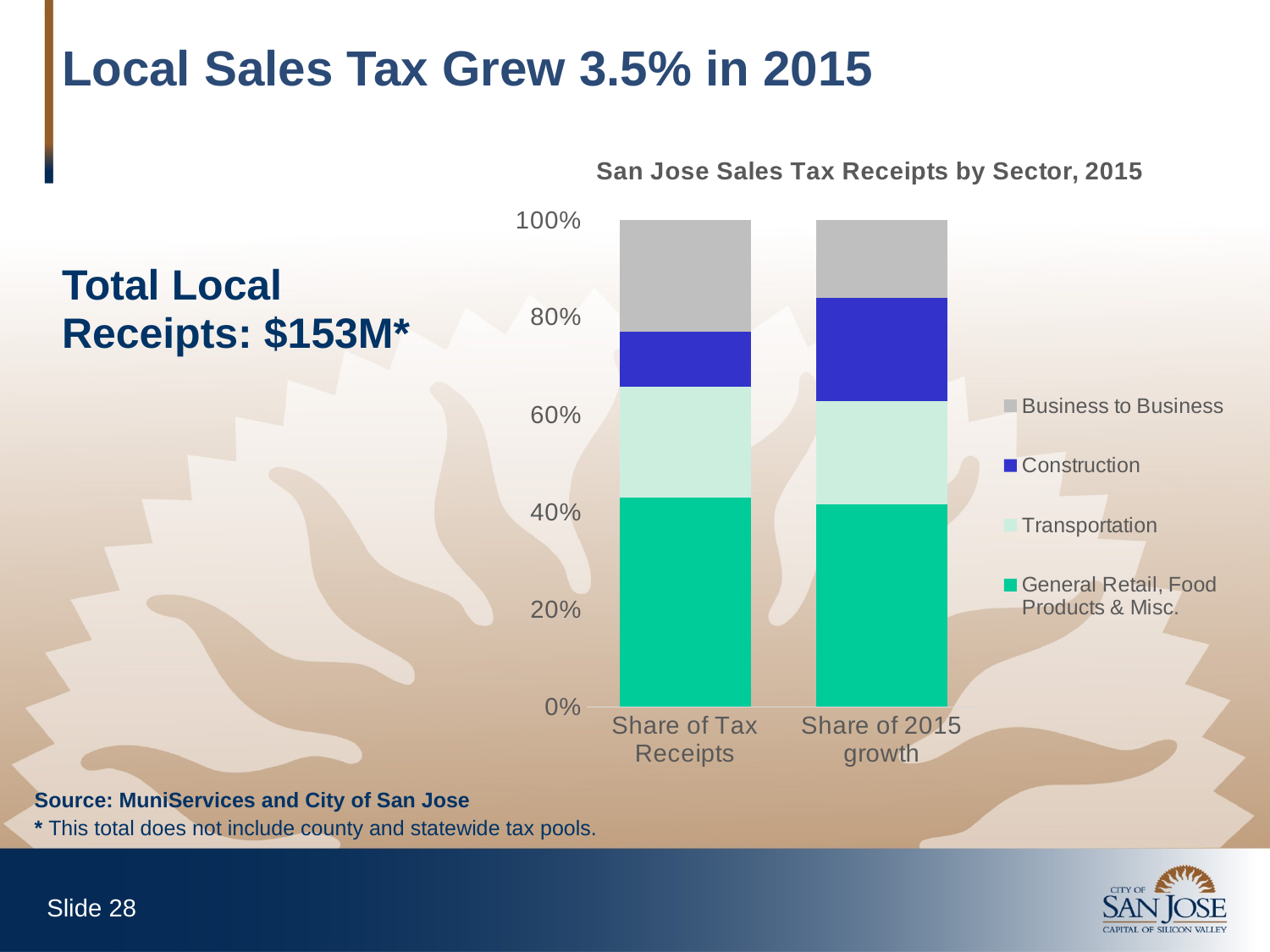
How many bars (categories) are plotted on the x axis? 2 Which colour represents Construction in the chart? Dark blue What type of chart is shown on the slide? Stacked bar chart Which sector is the smallest segment in the Share of 2015 growth bar? Business to Business Is the Construction segment larger in the Share of Tax Receipts bar or in the Share of 2015 growth bar? Share of 2015 growth What is the title of the chart? San Jose Sales Tax Receipts by Sector, 2015 Is the Business to Business segment larger in the Share of Tax Receipts bar or in the Share of 2015 growth bar? Share of Tax Receipts How many series does the chart legend list? 4 Is the General Retail, Food Products & Misc. share in the Share of Tax Receipts bar greater or less than 60%? less Which sector is the smallest segment in the Share of Tax Receipts bar? Construction Which sector is the largest segment in the Share of Tax Receipts bar? General Retail, Food Products & Misc. What is the total height of the Share of Tax Receipts stacked bar? 100%